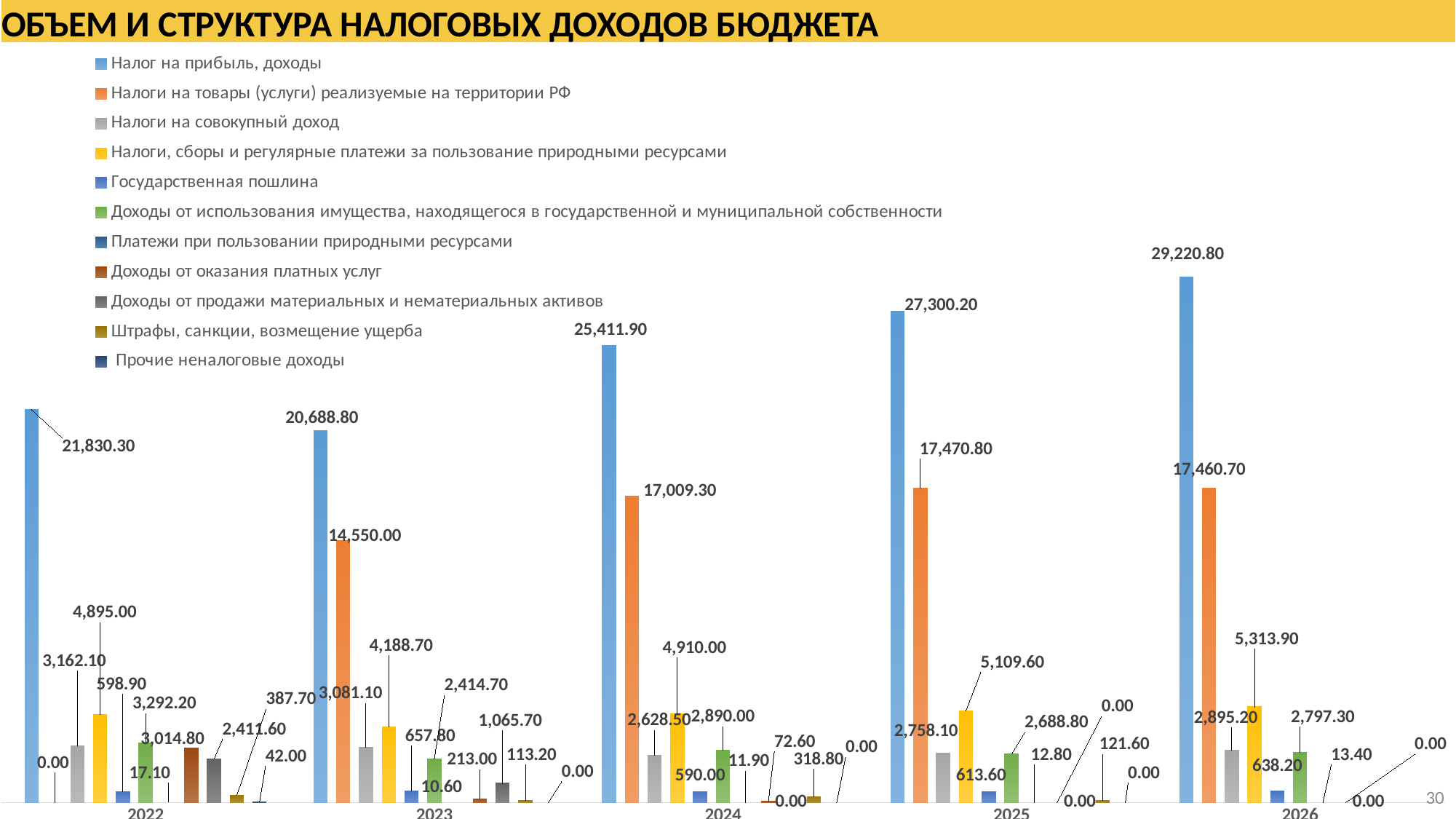
How many series does the legend list? 11 What is the value for Налог на прибыль, доходы in 2026? 29,220.80 What is the value for Налог на прибыль, доходы in 2022? 21,830.30 What is the value for Налоги на товары (услуги) реализуемые на территории РФ in 2024? 17,009.30 What is the title of the slide? ОБЪЕМ И СТРУКТУРА НАЛОГОВЫХ ДОХОДОВ БЮДЖЕТА What is the difference between Налог на прибыль, доходы in 2026 and in 2025? 1,920.60 What kind of chart is shown on the slide? Bar chart In which year is Налог на прибыль, доходы lowest? 2023 Which is larger in 2024: Налог на прибыль, доходы or Налоги на товары (услуги) реализуемые на территории РФ? Налог на прибыль, доходы In which year is Налог на прибыль, доходы highest? 2026 What is the value for Налоги, сборы и регулярные платежи за пользование природными ресурсами in 2025? 5,109.60 How many years are shown on the x axis? 5